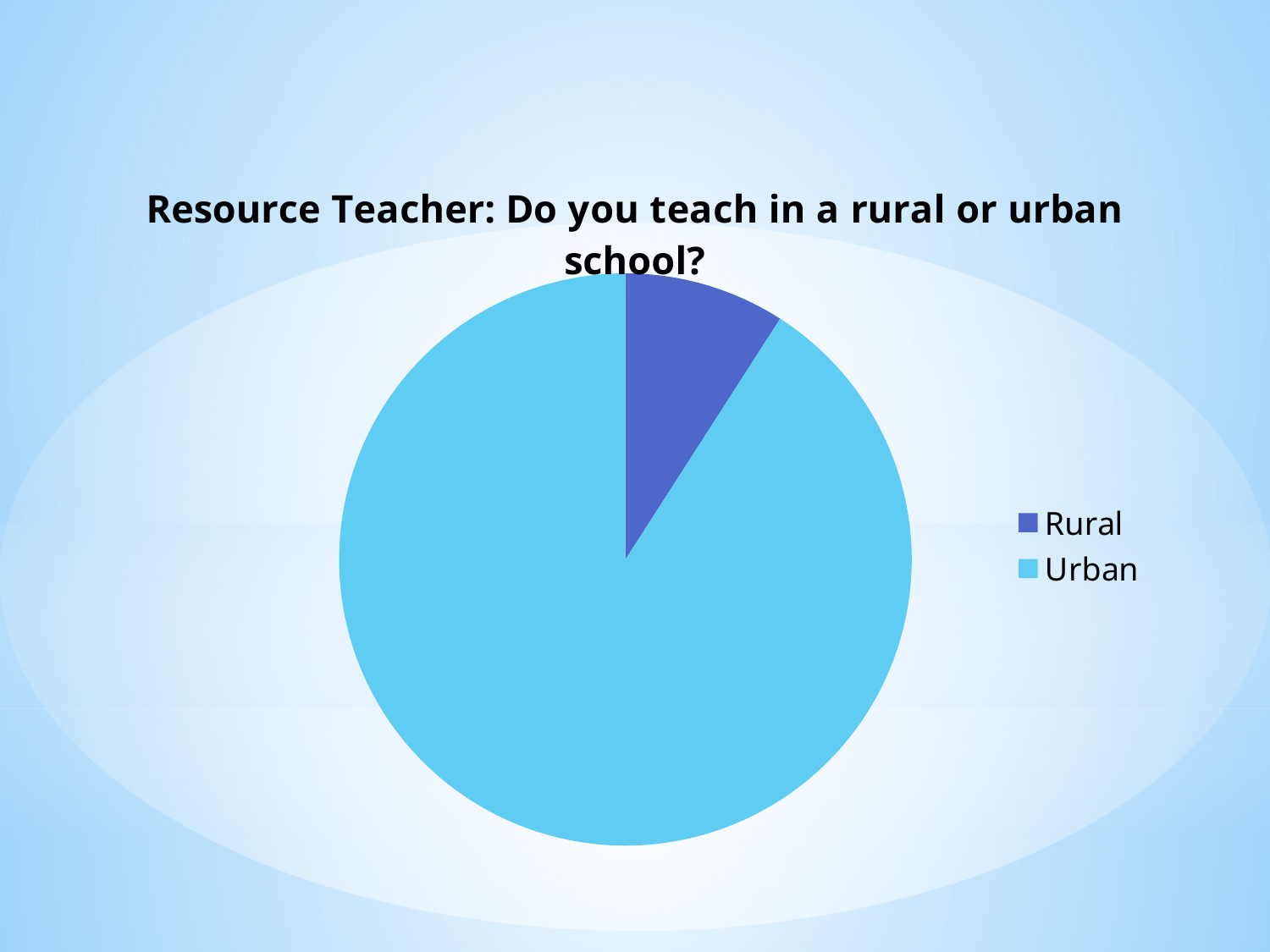
Which category has the smallest slice of the pie? Rural How many slices does the pie chart have? 2 Which slice is larger, Rural or Urban? Urban Which category has the largest slice of the pie? Urban How many entries does the legend list? 2 Which colour represents the Rural slice in the legend? dark blue What is the title of the chart? Resource Teacher: Do you teach in a rural or urban school? What kind of chart is shown on the slide? pie chart